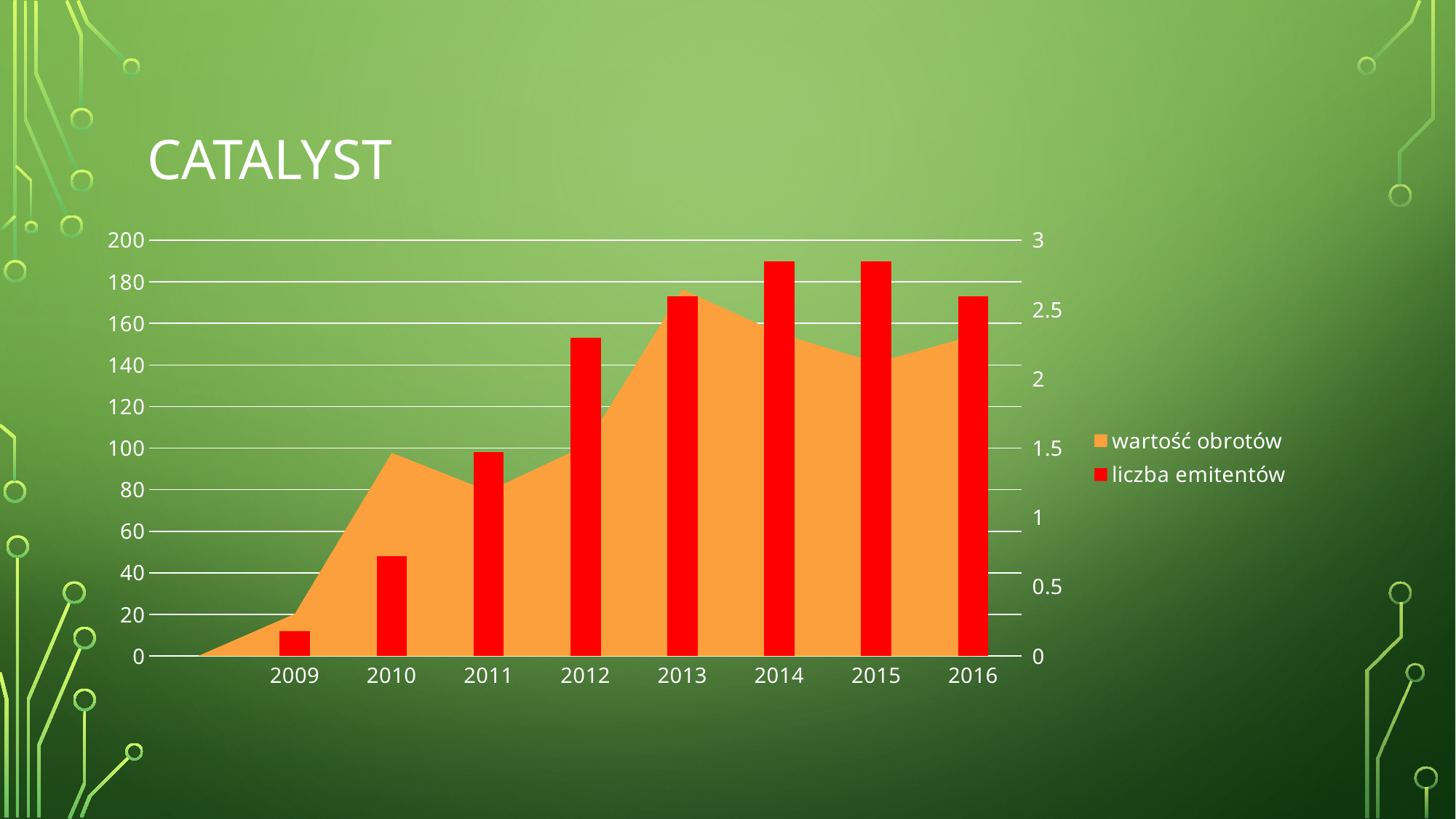
Which series is drawn as red bars? liczba emitentów In which year does the wartość obrotów area reach its highest point? 2013 What are the two series named in the legend? wartość obrotów and liczba emitentów Which year has the larger liczba emitentów bar, 2010 or 2011? 2011 In which year is the liczba emitentów bar lowest? 2009 How many years are shown on the x axis? 8 Do the liczba emitentów bars rise or fall from 2009 to 2014? rise How many series does the legend list? 2